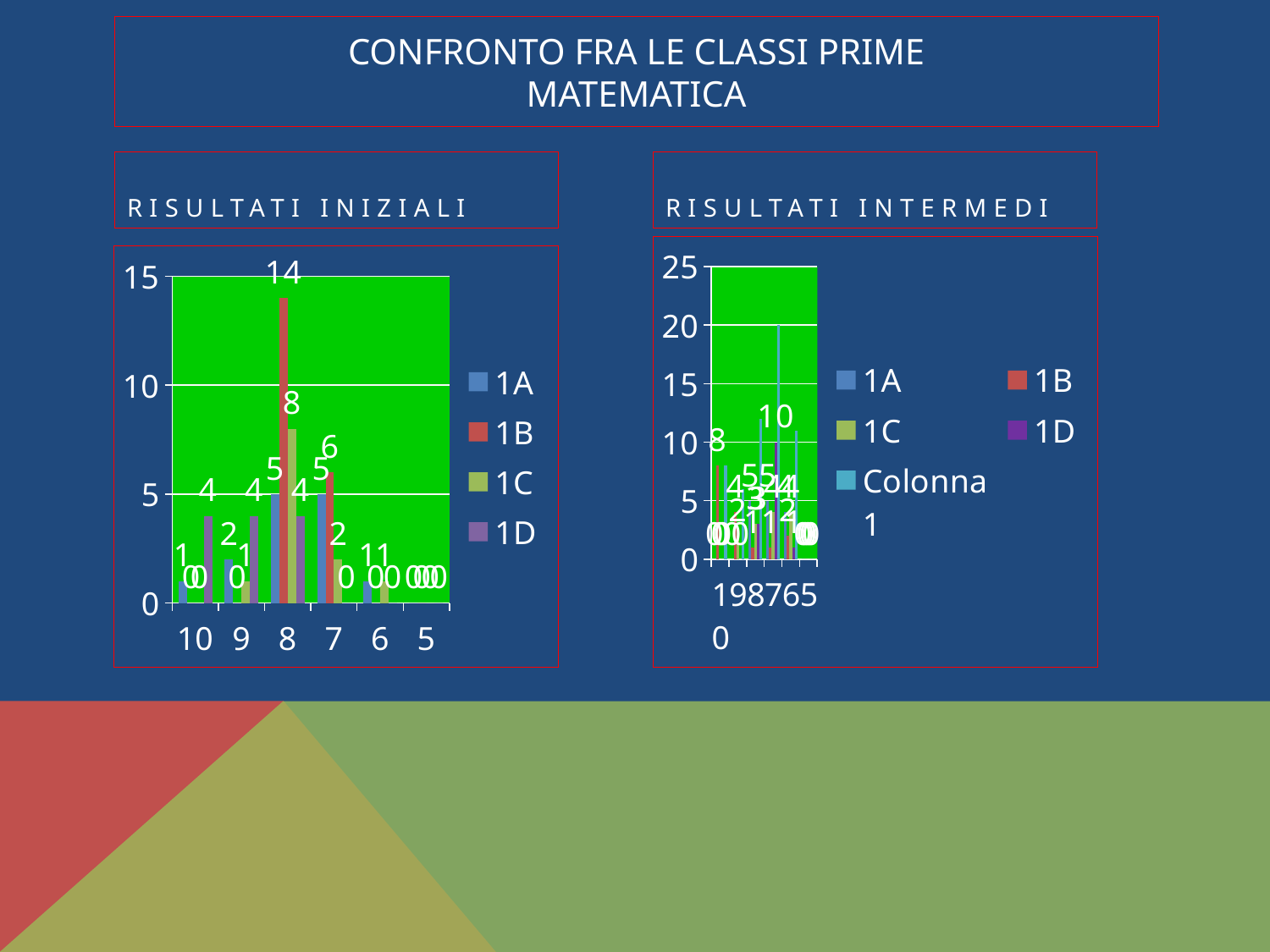
In the RISULTATI INIZIALI chart, which is larger at category 7: the value for 1A or the value for 1B? 1B In the RISULTATI INIZIALI chart, what is the value for 1B at category 8? 14 In the RISULTATI INIZIALI chart, what is the value for 1C at category 8? 8 In the RISULTATI INIZIALI chart, which series has the highest value at category 8? 1B What is the highest value shown on the y axis of the RISULTATI INTERMEDI chart? 25 What kind of chart is the RISULTATI INIZIALI chart? Bar chart In the RISULTATI INIZIALI chart, what is the value for 1D at category 10? 4 In the RISULTATI INIZIALI chart, what is the value for 1B at category 7? 6 How many categories are shown on the x axis of the RISULTATI INIZIALI chart? 6 In the RISULTATI INIZIALI chart, is the value for 1B at category 8 greater or less than 10? greater In the RISULTATI INIZIALI chart, what is the difference between the 1B and 1C values at category 8? 6 How many series does the legend of the RISULTATI INTERMEDI chart list? 5